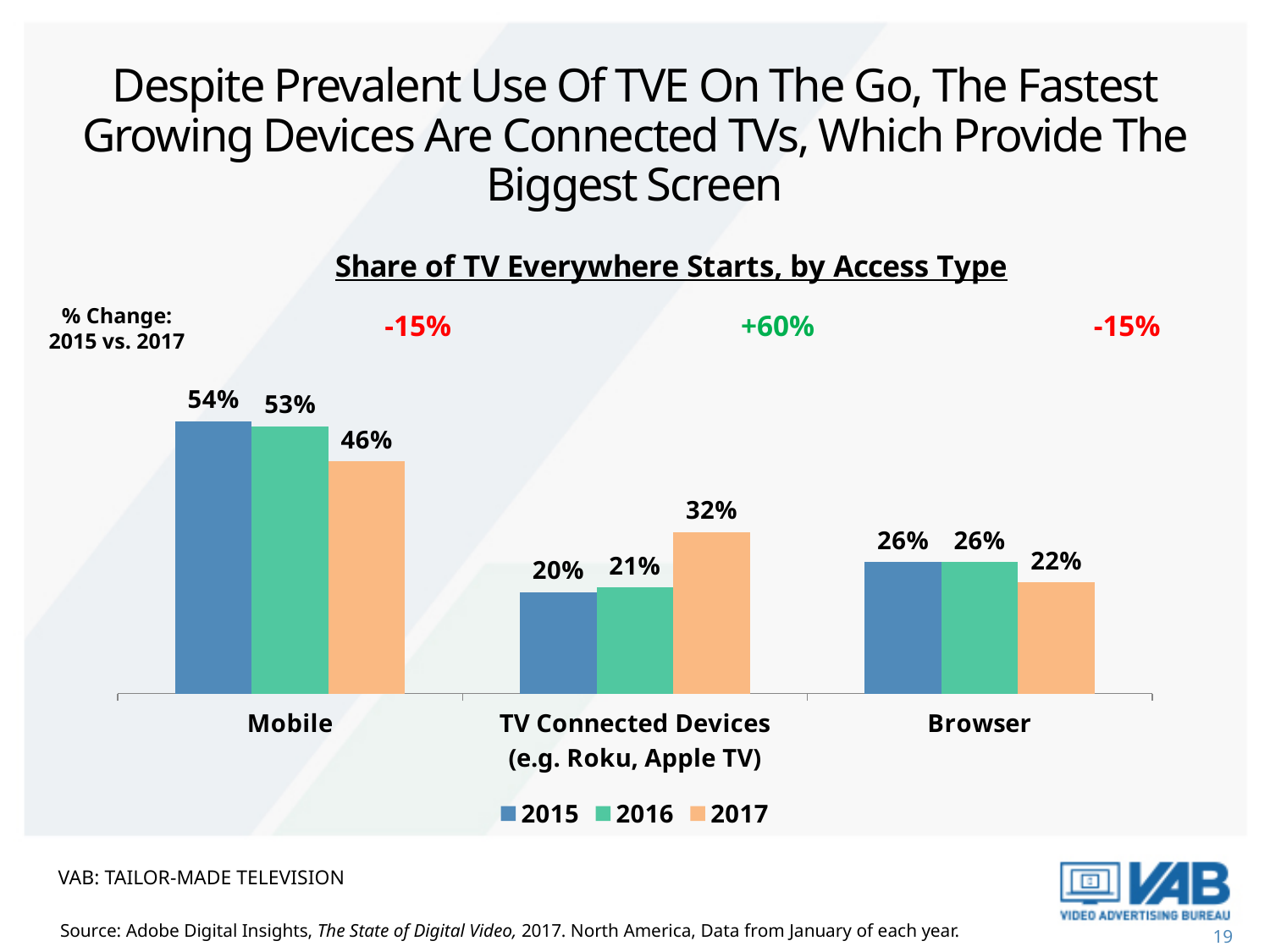
What percent change from 2015 to 2017 is shown above TV Connected Devices? +60% What is the difference between the 2015 and 2017 shares for Mobile? 8% Which is larger: the 2017 share for TV Connected Devices or the 2017 share for Browser? TV Connected Devices Do the values for TV Connected Devices rise or fall from 2015 to 2017? Rise What kind of chart is shown on the slide? Bar chart How many series does the legend list? 3 What is the 2015 share of TV Everywhere starts for Mobile? 54% Which access type has the lowest share in 2015? TV Connected Devices What is the 2017 share of TV Everywhere starts for TV Connected Devices? 32% Which access type has the highest share in 2017? Mobile What is the 2016 share of TV Everywhere starts for Browser? 26% How many access types are shown on the x axis? 3